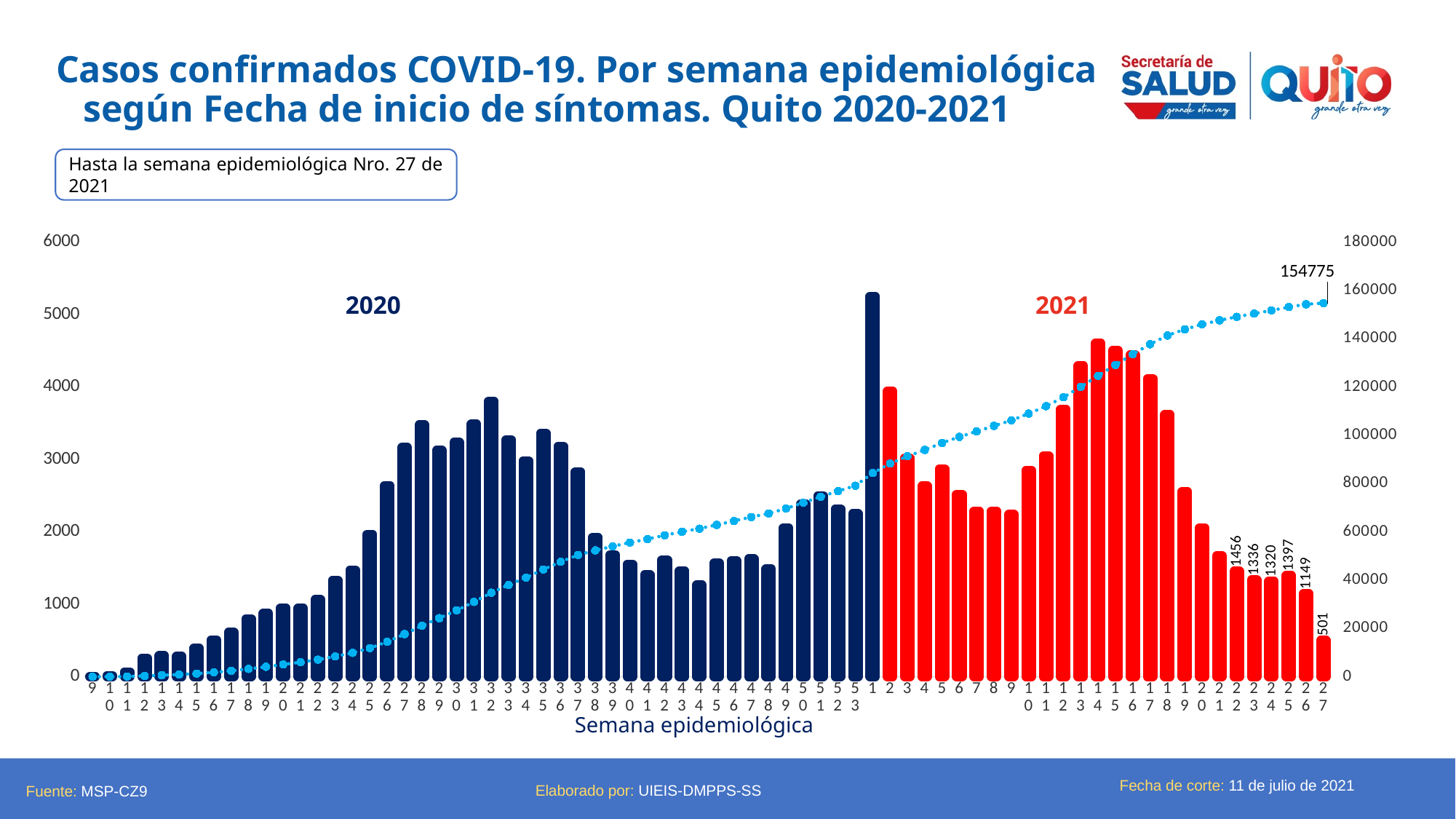
Which week has the tallest bar on the chart? week 1 (of 2021) What colour are the bars for 2021? red What is the difference between the values for week 25 and week 23 of 2021? 61 Is the value for week 32 of 2020 greater or less than 3000? greater What is the value of the bar for week 27 of 2021? 501 What value is labelled at the end of the dotted cumulative line at week 27 of 2021? 154775 Is the value for week 14 of 2021 greater or less than 4000? greater What is the difference between the values for week 22 and week 27 of 2021? 955 Does the dotted line rise or fall along the x axis? rises Is the value for week 18 of 2020 greater or less than 1000? less What is the value of the bar for week 22 of 2021? 1456 Which is larger, the value for week 24 or week 25 of 2021? week 25